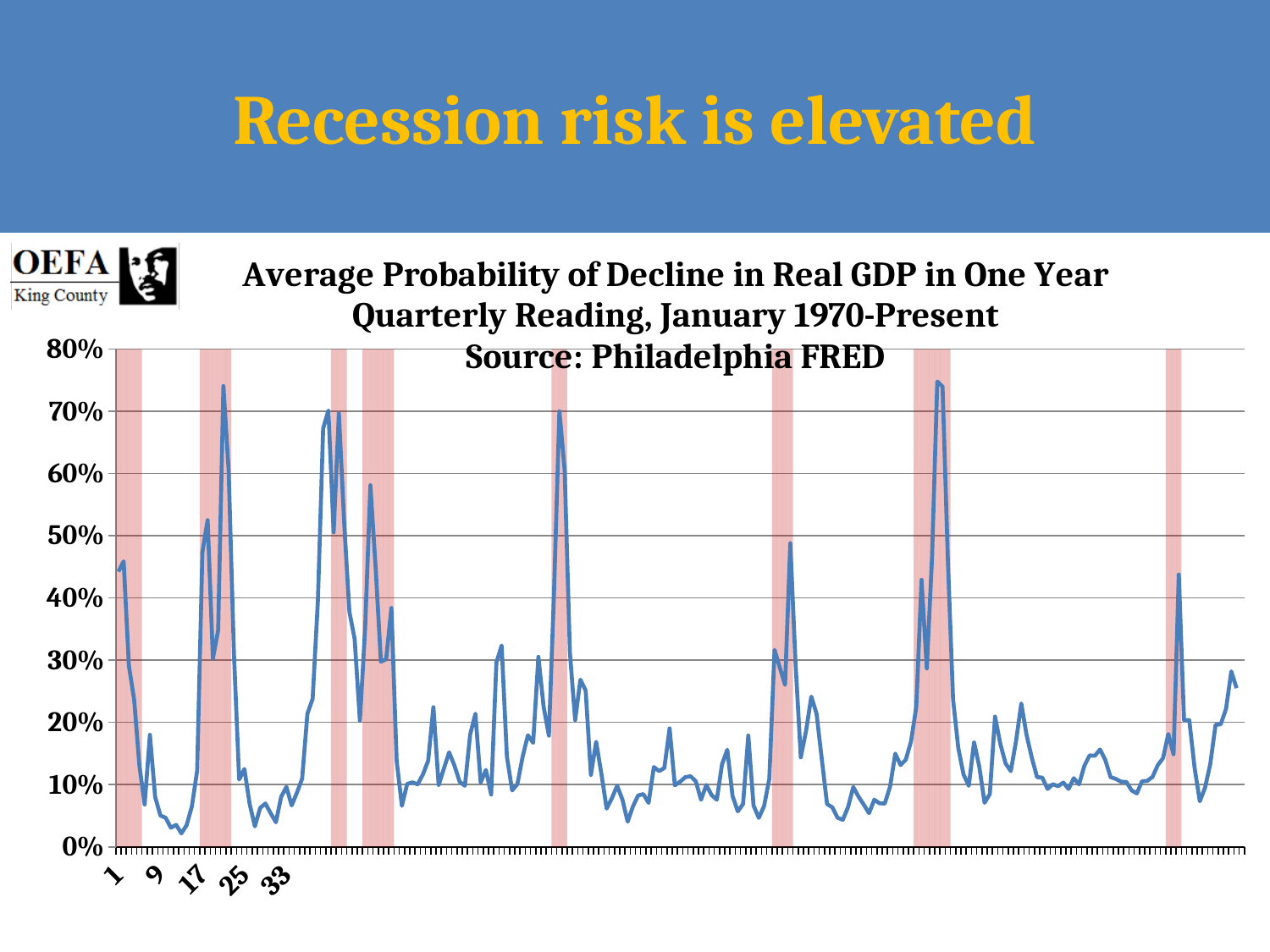
Is the last value plotted on the right end of the line greater or less than 20%? greater What is the title of the chart? Average Probability of Decline in Real GDP in One Year Quarterly Reading, January 1970-Present Source: Philadelphia FRED How many pink shaded vertical bands are drawn on the chart? 8 What kind of chart is shown on the slide? line chart Is the value at x = 1 greater or less than 40%? greater Is the value at x = 9 greater or less than 10%? less What is the highest value shown on the chart's y axis? 80% What source is cited for the chart's data? Philadelphia FRED